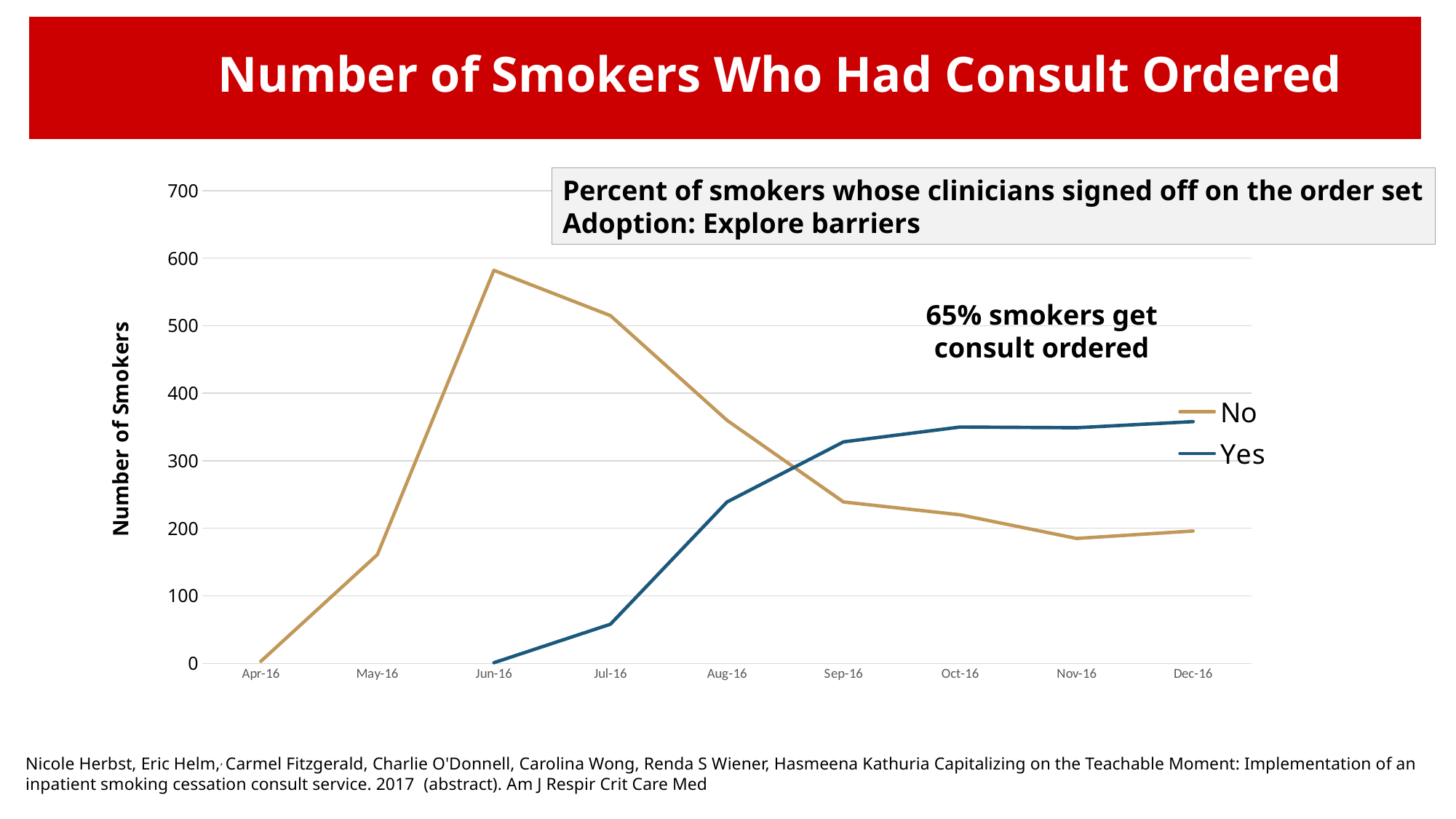
Is the value of the No series in Jun-16 greater or less than 500? greater What kind of chart is shown on the slide? line chart Is the value of the Yes series in Jul-16 greater or less than 100? less What is the label on the y axis? Number of Smokers In Dec-16, which series has the larger value, Yes or No? Yes In which month does the No series reach its highest value? Jun-16 Is the value of the Yes series in Dec-16 greater or less than 300? greater Does the Yes series rise or fall from Jun-16 to Dec-16? rise How many months are shown along the x axis? 9 How many series does the legend list? 2